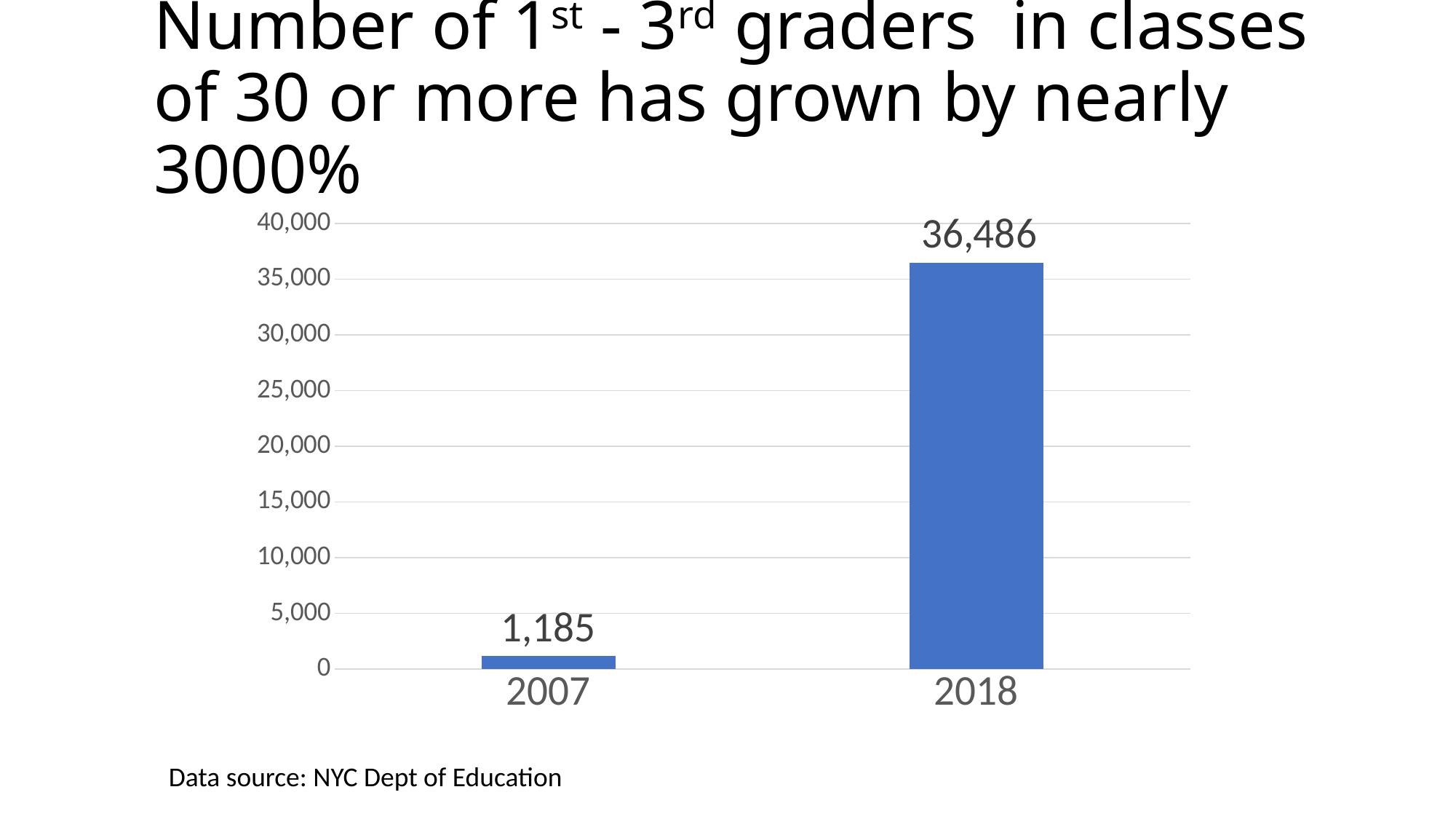
What is the value for 2007? 1,185 What is the difference between the values for 2018 and 2007? 35,301 Is the value for 2007 greater or less than 5,000? less What is the value for 2018? 36,486 Which is larger, the value for 2007 or the value for 2018? 2018 What is the data source cited on the slide? NYC Dept of Education What kind of chart is shown on the slide? bar chart Which year has the lowest value? 2007 Do the values rise or fall from 2007 to 2018? rise How many bars are shown in the chart? 2 Is the value for 2018 greater or less than 35,000? greater Which year has the highest value? 2018